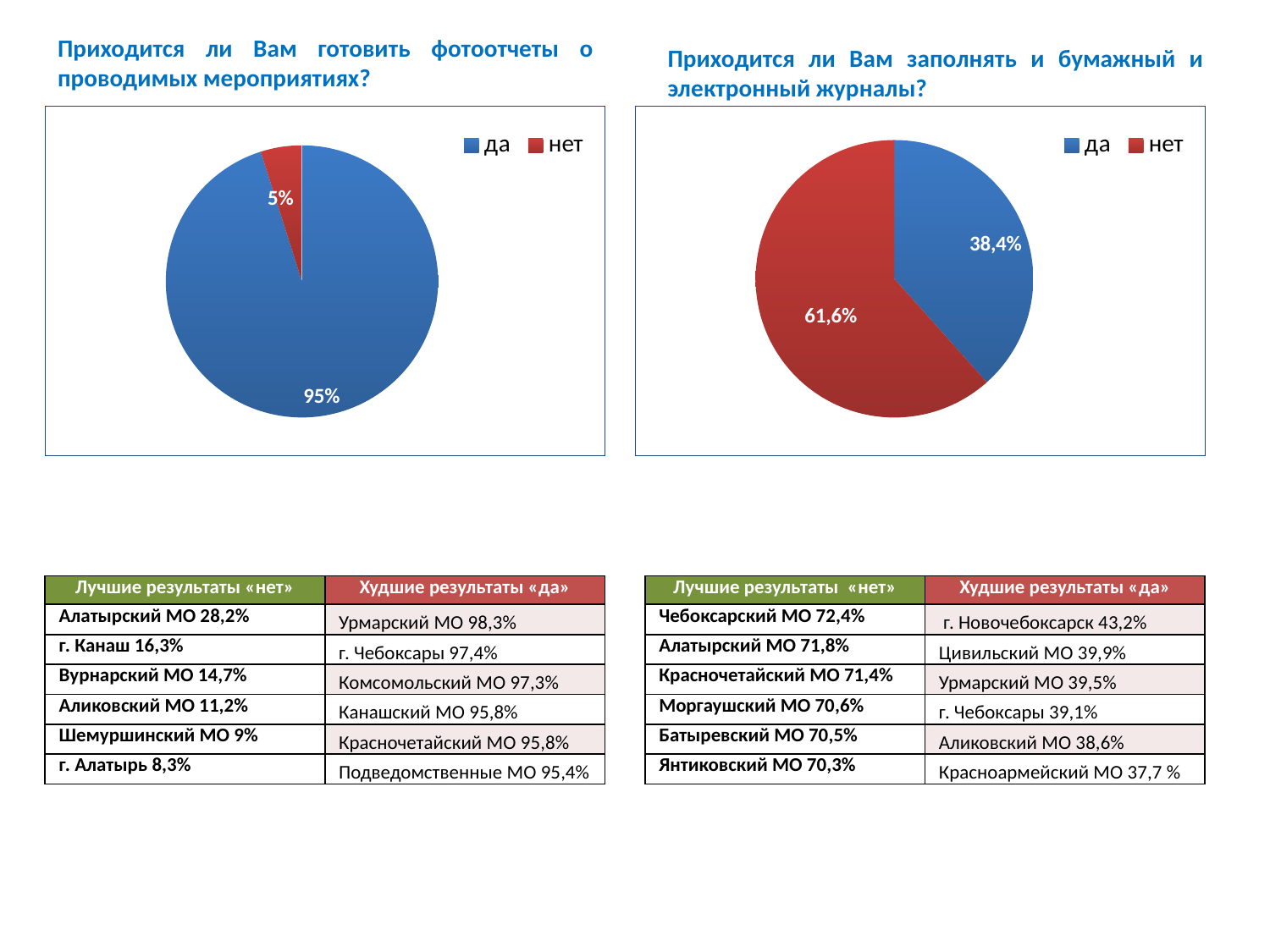
In the right chart ("Приходится ли Вам заполнять и бумажный и электронный журналы?"), which answer has the smallest slice? да In the left chart ("Приходится ли Вам готовить фотоотчеты о проводимых мероприятиях?"), what colour is the "нет" slice? Red How many entries does the legend of the right chart ("Приходится ли Вам заполнять и бумажный и электронный журналы?") list? 2 In the right chart ("Приходится ли Вам заполнять и бумажный и электронный журналы?"), what share of respondents answered "нет"? 61,6% In the left chart ("Приходится ли Вам готовить фотоотчеты о проводимых мероприятиях?"), what share of respondents answered "да"? 95% In the left chart ("Приходится ли Вам готовить фотоотчеты о проводимых мероприятиях?"), what share of respondents answered "нет"? 5% What type of chart is the left chart ("Приходится ли Вам готовить фотоотчеты о проводимых мероприятиях?")? Pie chart In the right chart ("Приходится ли Вам заполнять и бумажный и электронный журналы?"), what share of respondents answered "да"? 38,4% In the left chart ("Приходится ли Вам готовить фотоотчеты о проводимых мероприятиях?"), which answer has the largest slice? да In the right chart ("Приходится ли Вам заполнять и бумажный и электронный журналы?"), what is the difference in percentage points between the "нет" and "да" slices? 23,2 percentage points In the right chart ("Приходится ли Вам заполнять и бумажный и электронный журналы?"), which is larger, the "да" slice or the "нет" slice? нет In the left chart ("Приходится ли Вам готовить фотоотчеты о проводимых мероприятиях?"), what is the difference in percentage points between the "да" and "нет" slices? 90 percentage points